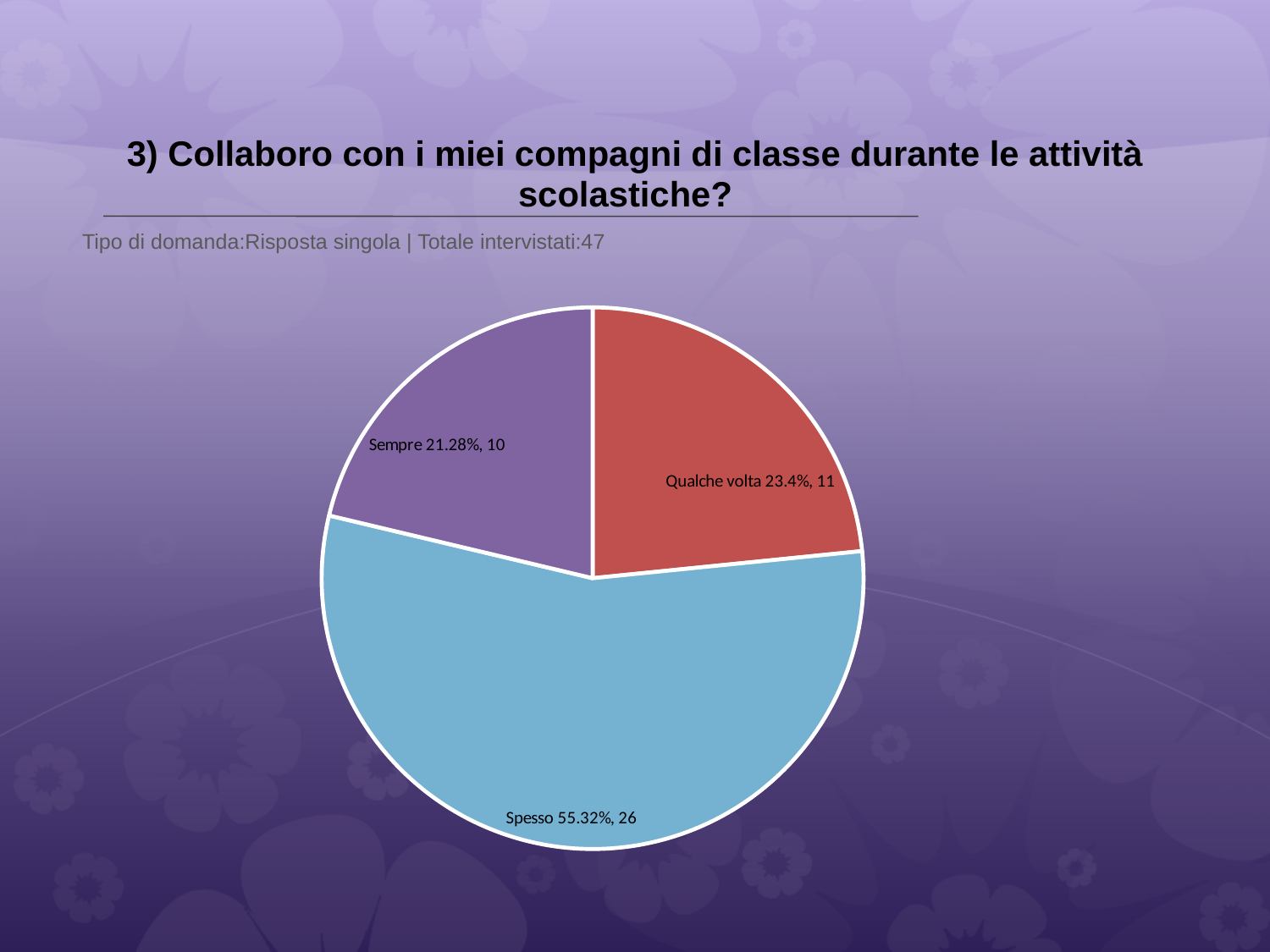
Which category has the smallest slice? Sempre Which category has the largest slice? Spesso What is the total number of respondents shown on the slide? 47 How many respondents answered 'Qualche volta'? 11 How many respondents answered 'Sempre'? 10 What kind of chart is shown on the slide? pie chart Which has more respondents, 'Qualche volta' or 'Sempre'? Qualche volta What colour is the 'Spesso' slice? blue What percentage share does the 'Spesso' slice have? 55.32% What percentage share does the 'Sempre' slice have? 21.28% How many slices does the pie chart have? 3 What is the difference in respondent count between 'Spesso' and 'Qualche volta'? 15